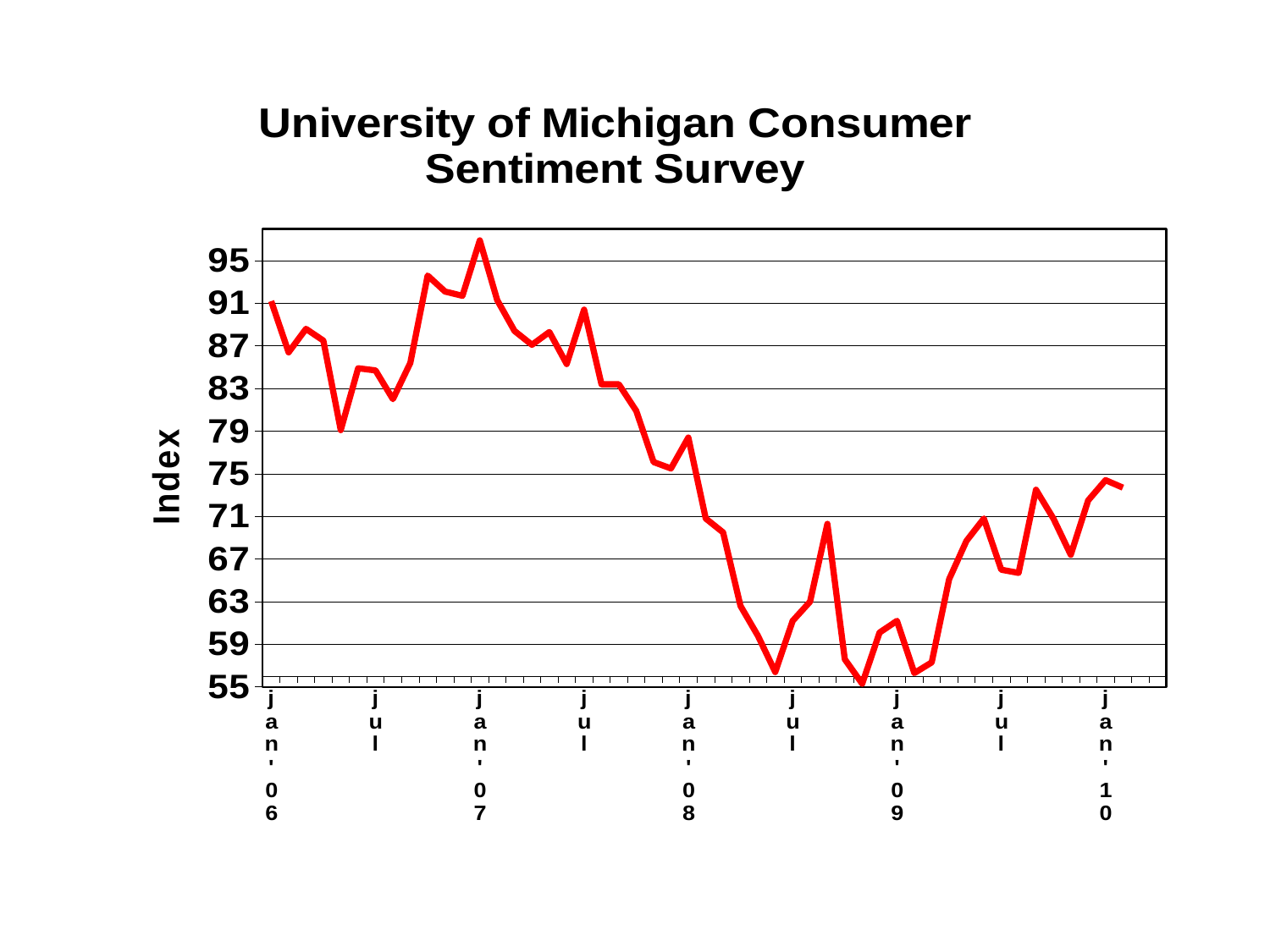
Is the value at jul-09 greater or less than 71? less What kind of chart is shown on the slide? line chart Is the value at jan-08 greater or less than 75? greater Is the value at jan-09 greater or less than 63? less How many labels are shown along the x axis? 9 Which is higher, the value at jan-06 or the value at jan-10? jan-06 What is the label on the vertical axis? Index Overall, does the index rise or fall between jan-06 and jan-10? fall What is the title of the chart? University of Michigan Consumer Sentiment Survey Which is higher, the value at jan-08 or the value at jan-09? jan-08